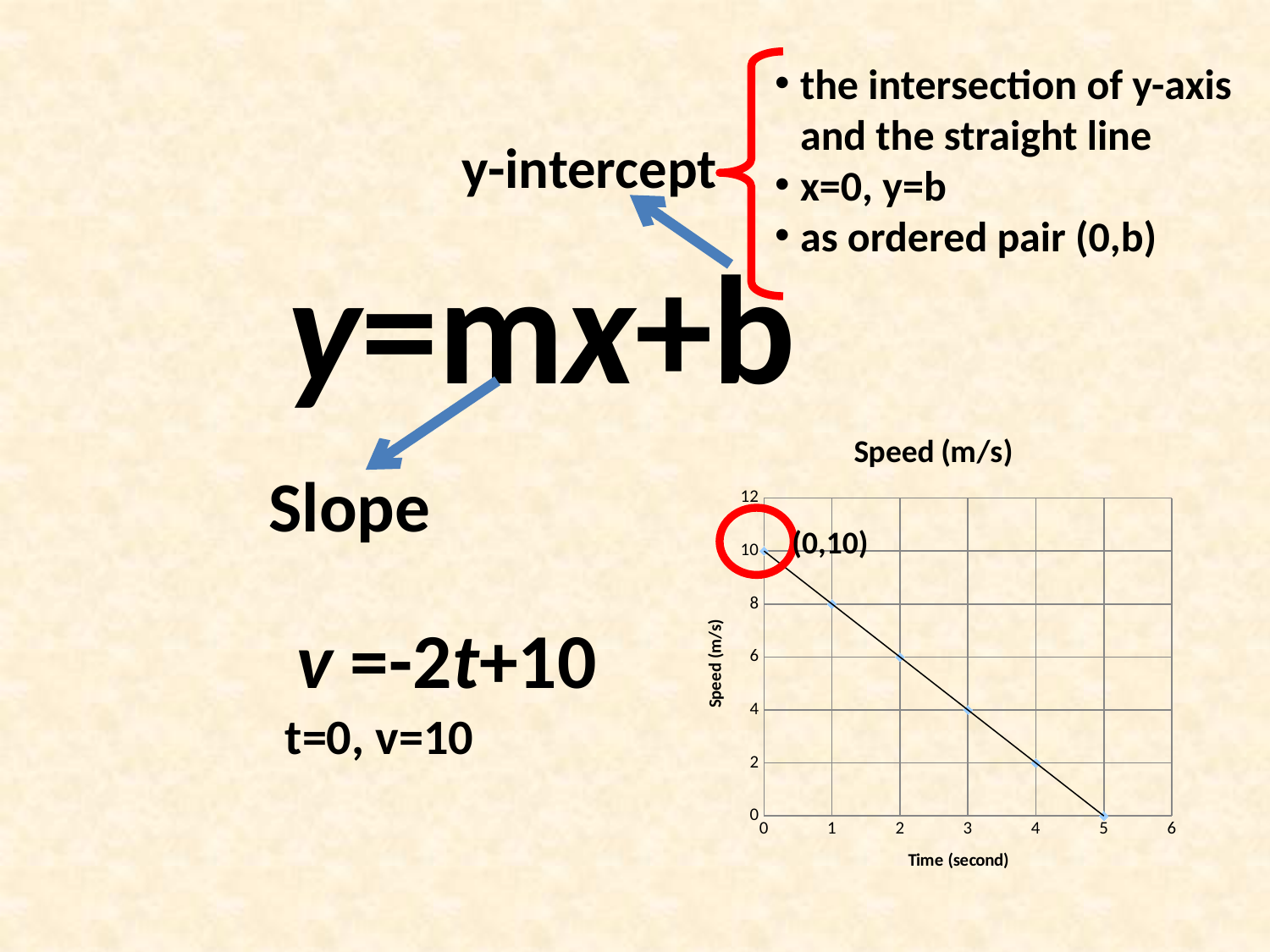
What is the label of the x axis of the chart? Time (second) What is the speed at time 5 seconds? 0 Do the speed values rise or fall as time increases? fall Which is larger, the speed at time 1 or the speed at time 4? time 1 How many data points are plotted on the chart? 6 At which time is the speed lowest? 5 What is the speed at time 3 seconds? 4 What kind of chart is shown on the slide? line chart At which time is the speed highest? 0 What is the title of the chart? Speed (m/s) What is the speed at time 0 seconds? 10 What is the difference between the speed at time 0 and the speed at time 5? 10